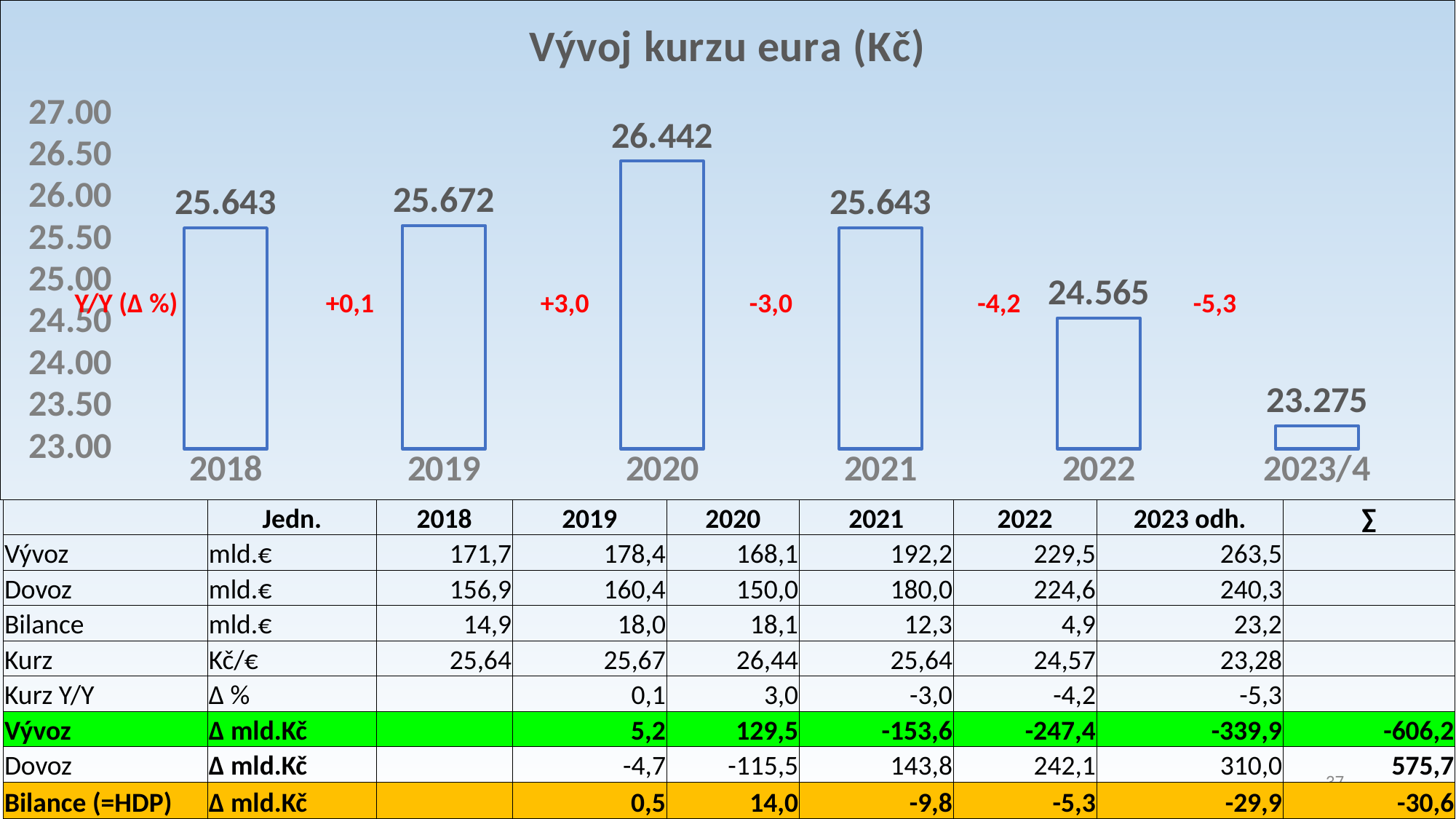
What is the value shown for 2023/4 in the chart? 23.275 How many bars are plotted in the chart? 6 Is the value for 2022 greater or less than 25.00? less Which is larger, the value for 2019 or the value for 2018? 2019 What is the value shown for 2020 in the chart? 26.442 What is the value shown for 2022 in the chart? 24.565 What is the difference between the values for 2020 and 2021? 0.799 What is the difference between the values for 2022 and 2023/4? 1.290 Which category has the lowest value in the chart? 2023/4 Which year has the highest value in the chart? 2020 What kind of chart is shown on the slide? bar chart Do the values rise or fall from 2020 to 2023/4? fall